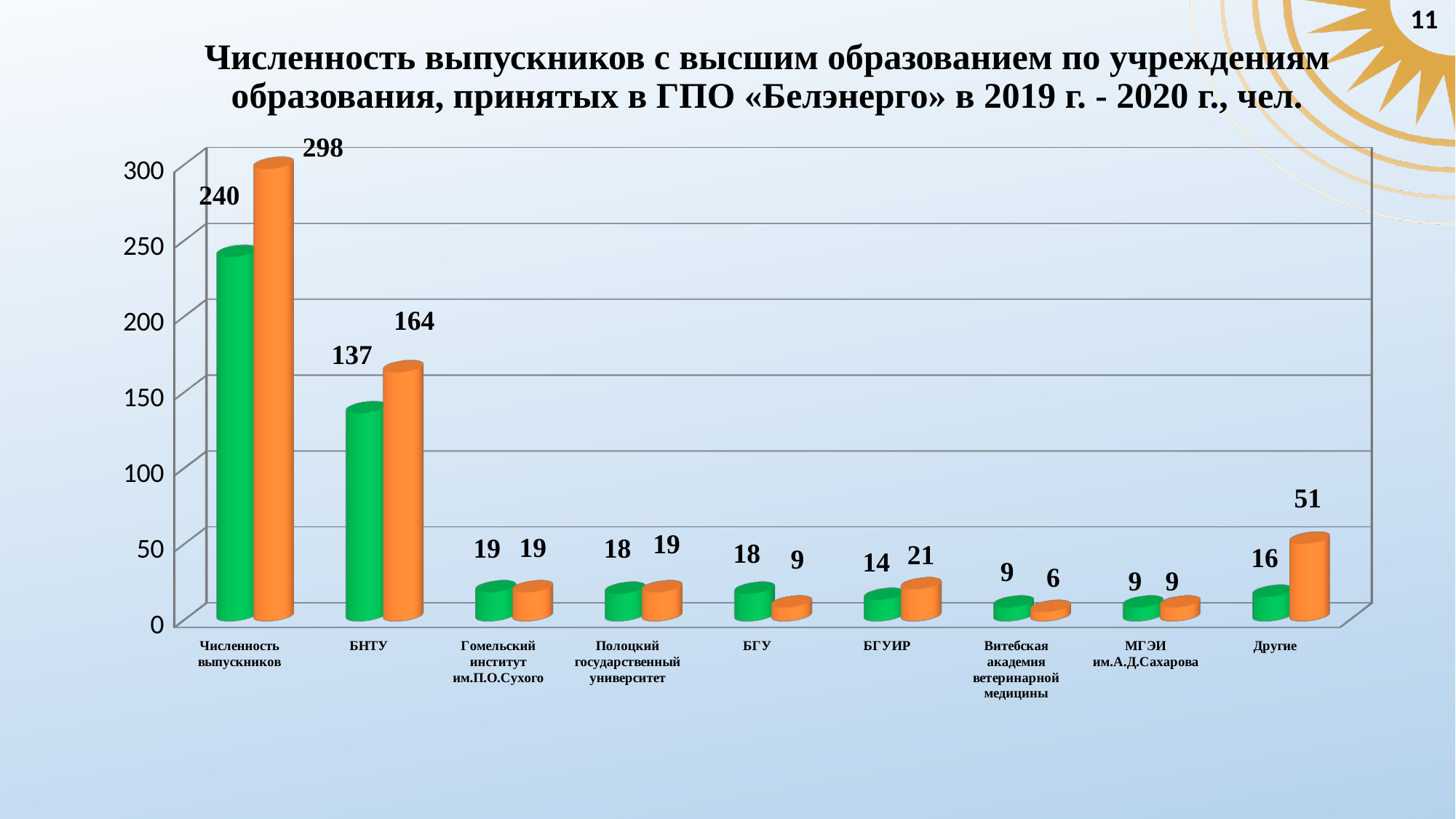
Which category has the highest orange bar? Численность выпускников What is the value of the orange bar for Другие? 51 What is the value of the green bar for БГУ? 18 Which category has the lowest orange bar? Витебская академия ветеринарной медицины How many categories are shown on the x axis? 9 What type of chart is shown on the slide? bar chart What colours are the two series of bars in the chart? green and orange What is the difference between the orange and green bars for БНТУ? 27 What is the value of the green bar for БНТУ? 137 For БГУ, which bar is larger, the green or the orange? green What is the value of the orange bar for БГУИР? 21 What is the difference between the orange and green bars for Численность выпускников? 58